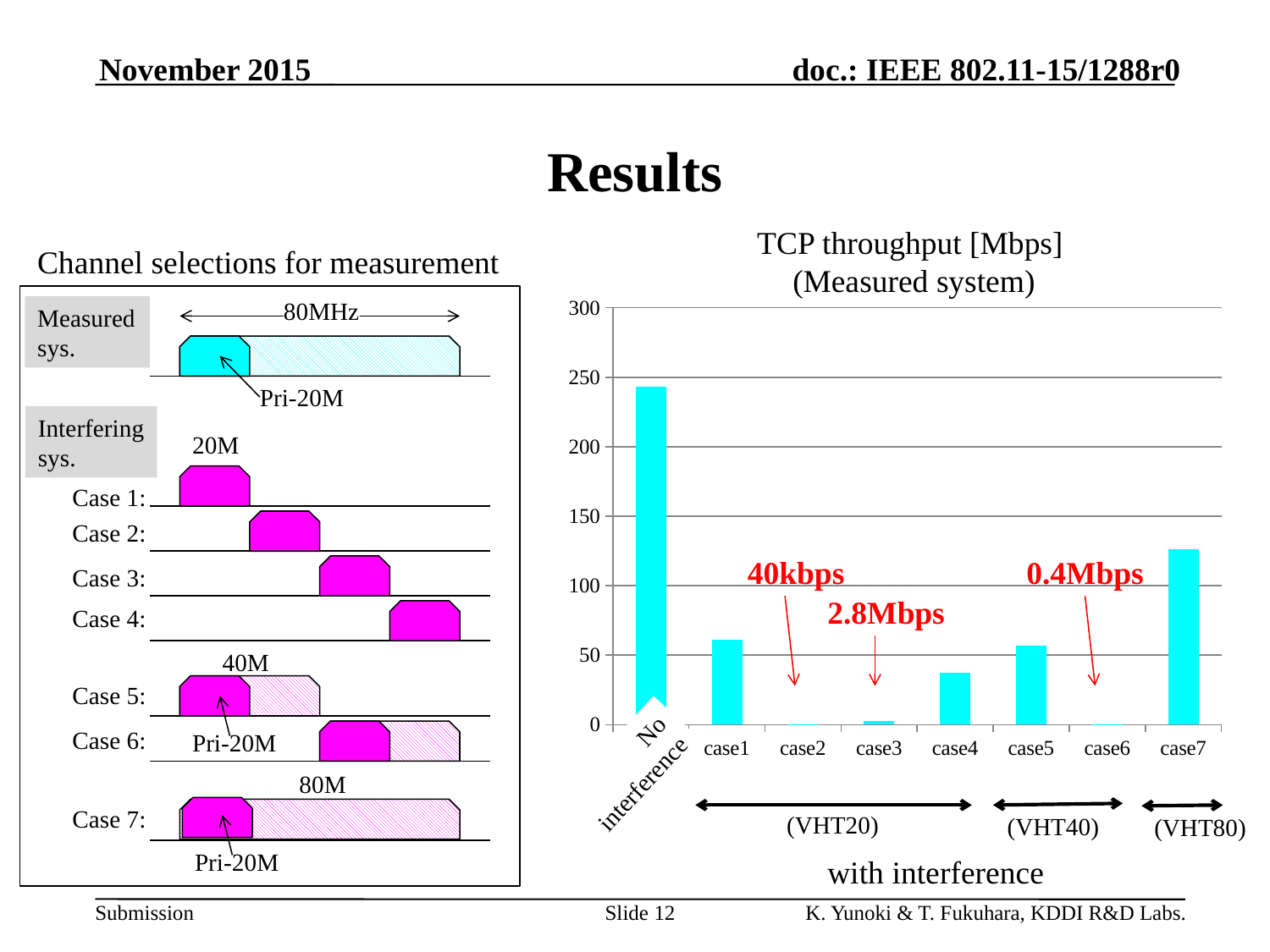
Which category has the highest TCP throughput in the chart? No interference What is the title of the chart on the slide? TCP throughput [Mbps] (Measured system) What TCP throughput value is annotated for case3? 2.8Mbps Is the TCP throughput for No interference greater or less than 200? greater Is the TCP throughput for case7 greater or less than 100? greater What kind of chart is the TCP throughput chart on the slide? bar chart What TCP throughput value is annotated for case2? 40kbps Which has the higher TCP throughput, case1 or case4? case1 How many categories are plotted on the x axis of the TCP throughput chart? 8 What TCP throughput value is annotated for case6? 0.4Mbps Which category has the lowest TCP throughput in the chart? case2 Which has the higher TCP throughput, case7 or case5? case7